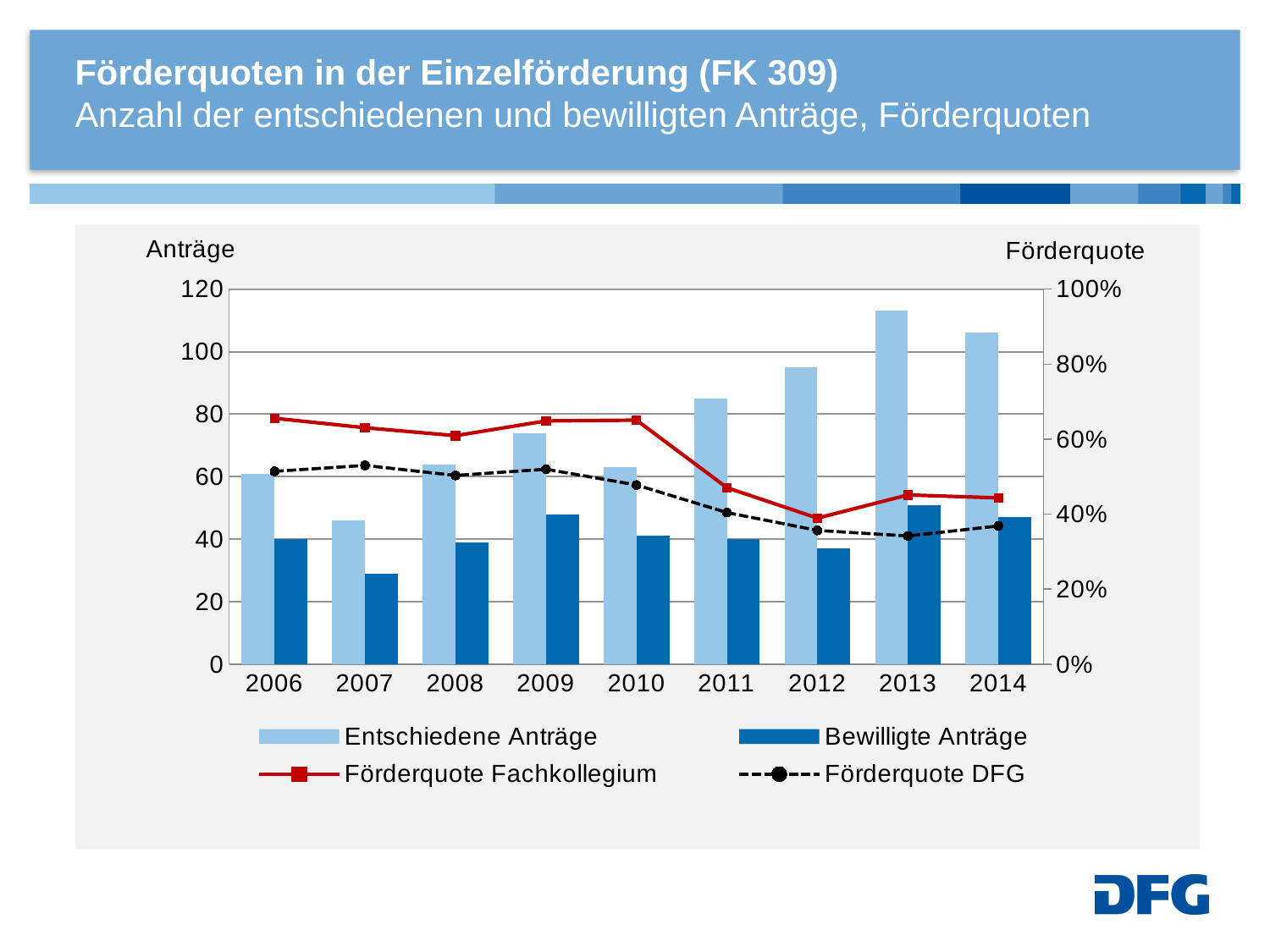
What is the label of the right-hand vertical axis? Förderquote Is the value for Bewilligte Anträge in 2007 greater or less than 40? less In which year is the number of Bewilligte Anträge lowest? 2007 In which year is the number of Entschiedene Anträge highest? 2013 Does the Förderquote DFG overall rise or fall from 2006 to 2014? fall In 2006, which is higher: the Förderquote Fachkollegium or the Förderquote DFG? Förderquote Fachkollegium How many series does the legend list? 4 Is the value for Entschiedene Anträge in 2014 greater or less than 100? greater How many years are shown on the x axis? 9 What kind of chart is used to show the Entschiedene Anträge and Bewilligte Anträge series? Bar chart In which year is the number of Entschiedene Anträge lowest? 2007 Is the Förderquote DFG in 2013 greater or less than 40%? less